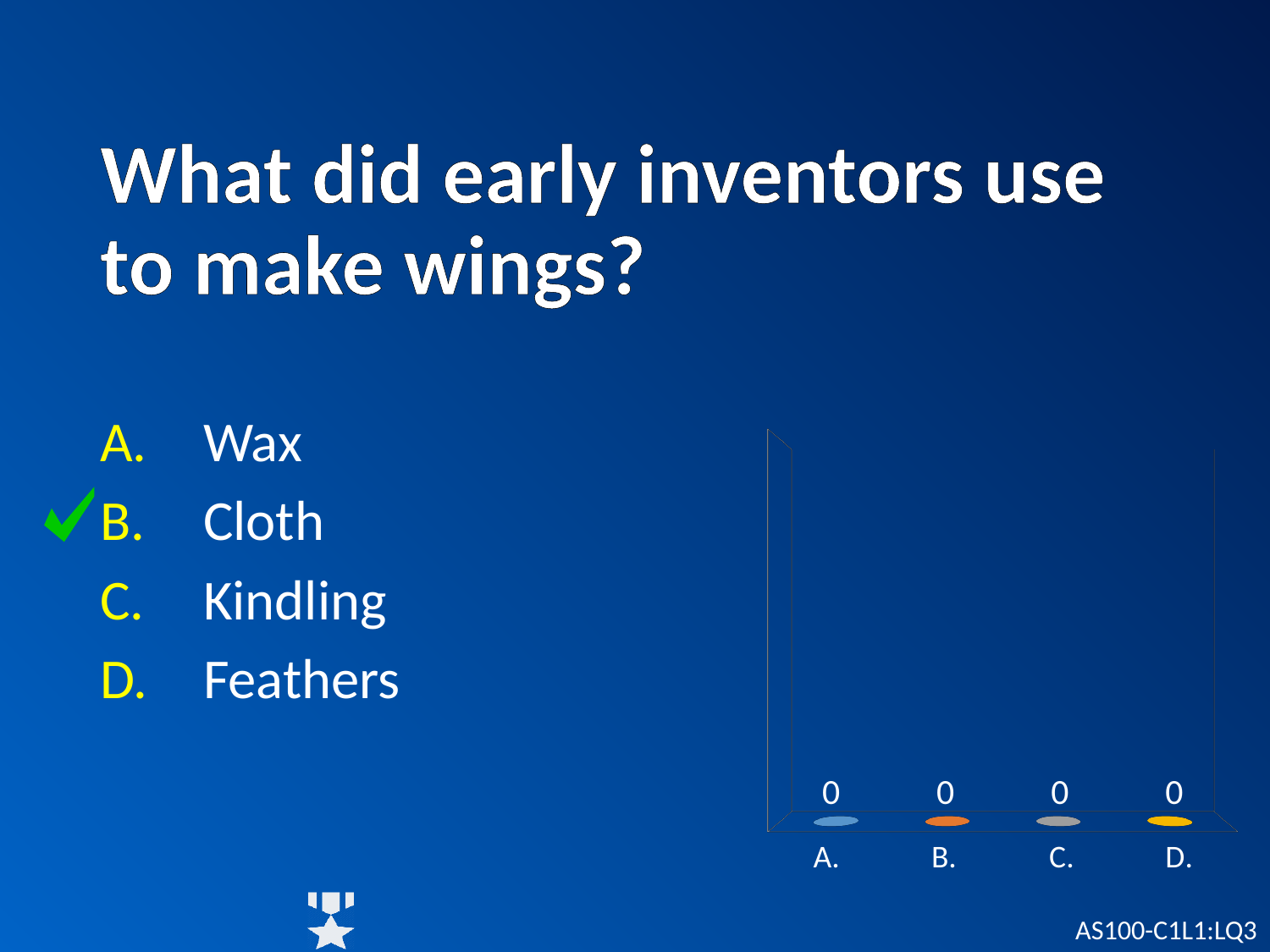
What is the value shown for category A. in the chart? 0 What is the value shown for category D. in the chart? 0 What is the value shown for category C. in the chart? 0 How many categories are plotted on the chart's x axis? 4 What colour is the bar for category D. in the chart? yellow Do the values in the chart rise, fall, or stay flat from A. to D.? stay flat What is the difference between the values for A. and D. in the chart? 0 What is the value shown for category B. in the chart? 0 What are the category labels along the x axis of the chart? A., B., C., D. What kind of chart is shown on the slide? bar chart